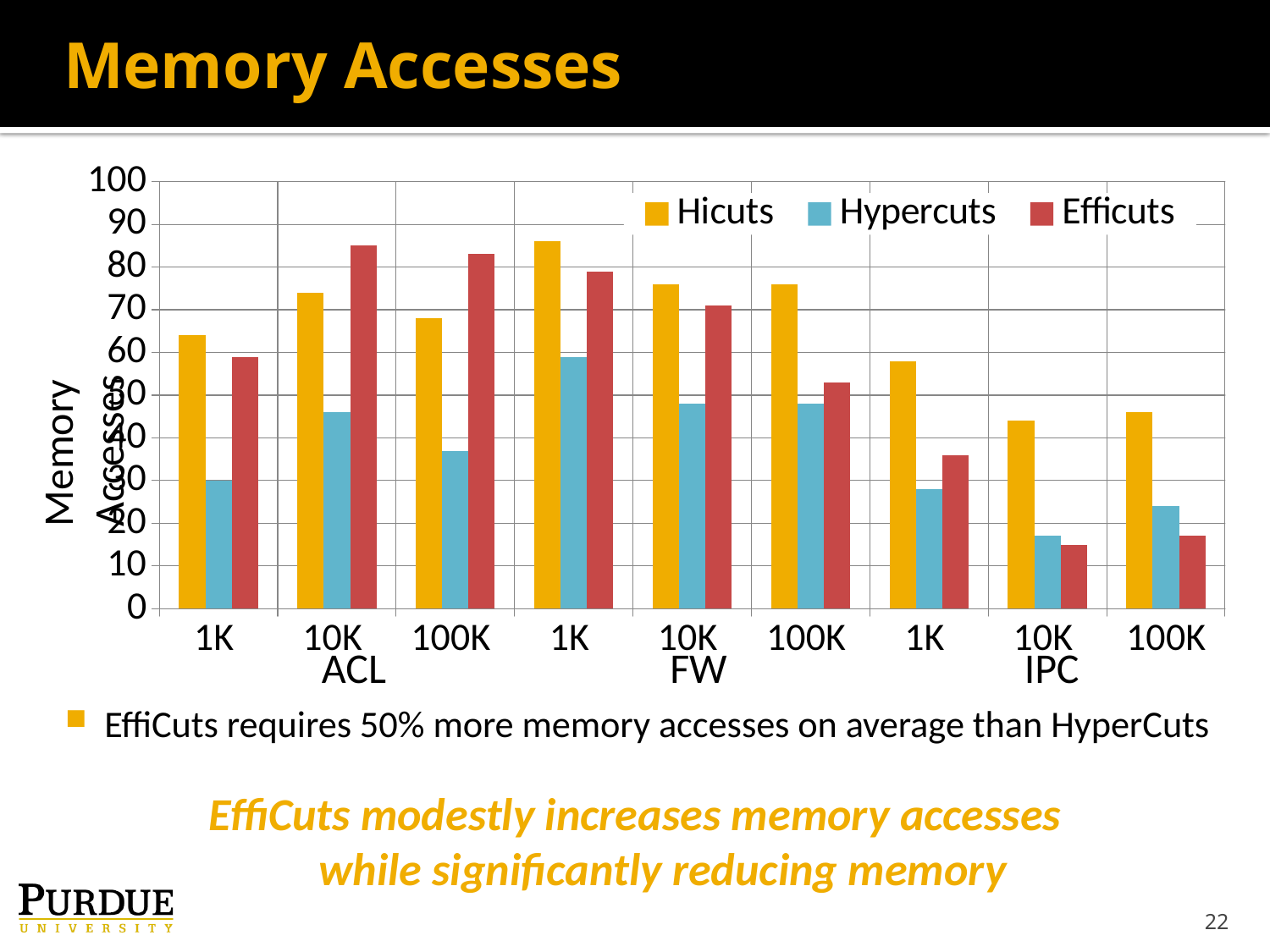
For FW 1K, which is larger: Hicuts or Efficuts? Hicuts What kind of chart is shown on the slide? bar chart Is the Hicuts value for ACL 1K greater or less than 60? greater Which series are listed in the legend? Hicuts, Hypercuts, Efficuts For ACL 10K, which is larger: Hicuts or Efficuts? Efficuts For which category is the Hypercuts value lowest? IPC 10K For which category does Hicuts reach its highest value? FW 1K How many series does the legend list? 3 Is the Efficuts value for ACL 10K greater or less than 80? greater Is the Hypercuts value for FW 1K greater or less than 50? greater How many groups of bars are plotted along the x axis? 9